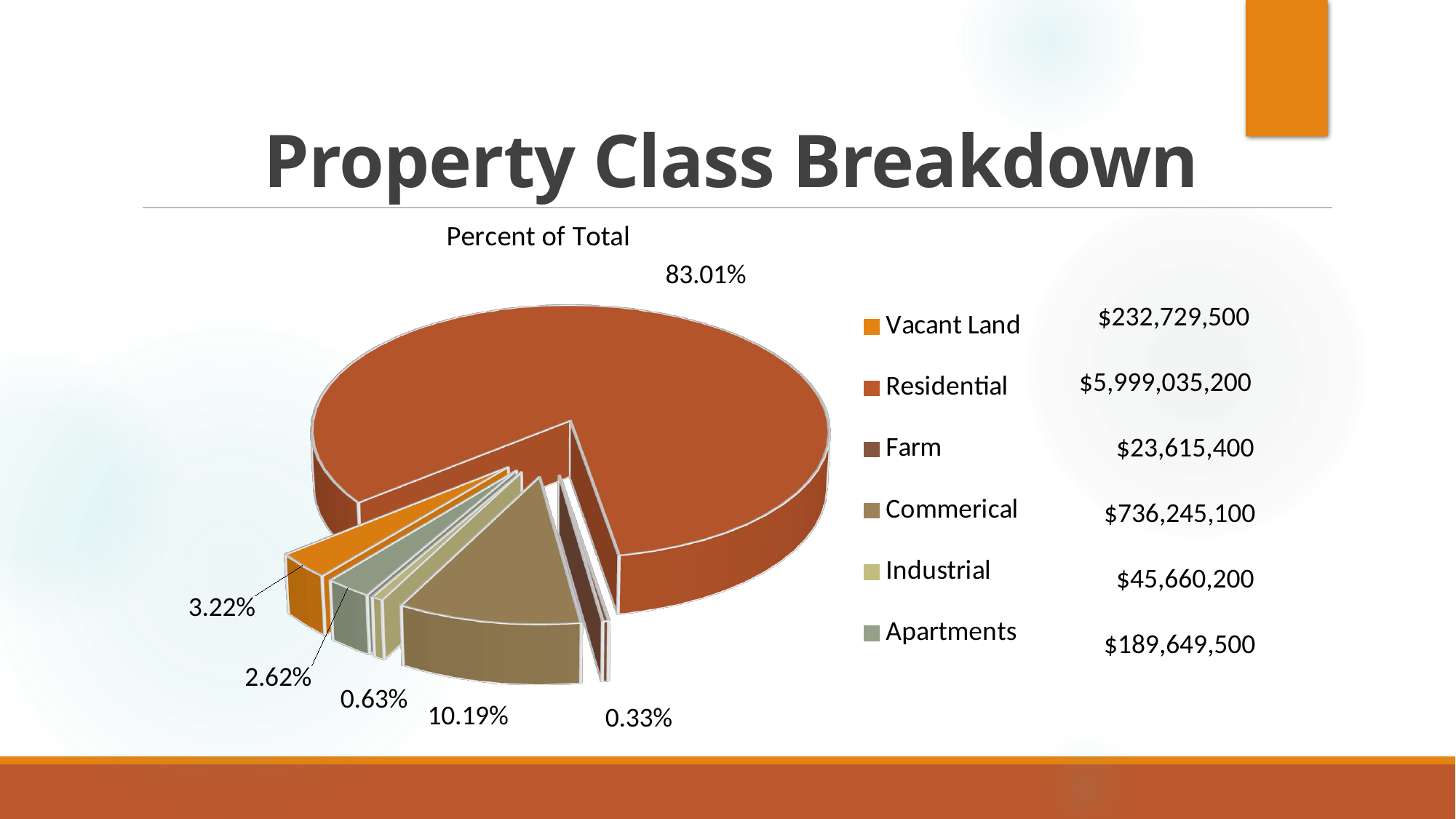
What type of chart is shown on the slide? pie chart What is the difference in percentage points between the Residential and Commerical shares? 72.82 Which has a larger share, Apartments or Industrial? Apartments What dollar value is shown next to Industrial in the legend? $45,660,200 How many slices does the pie chart have? 6 What percentage of the total does Vacant Land represent? 3.22% What percentage of the total does Commerical represent? 10.19% What percentage of the total does Residential represent? 83.01% What is the title of the chart? Percent of Total What percentage of the total does Farm represent? 0.33% Which property class has the smallest share of the pie? Farm Which property class has the largest share of the pie? Residential